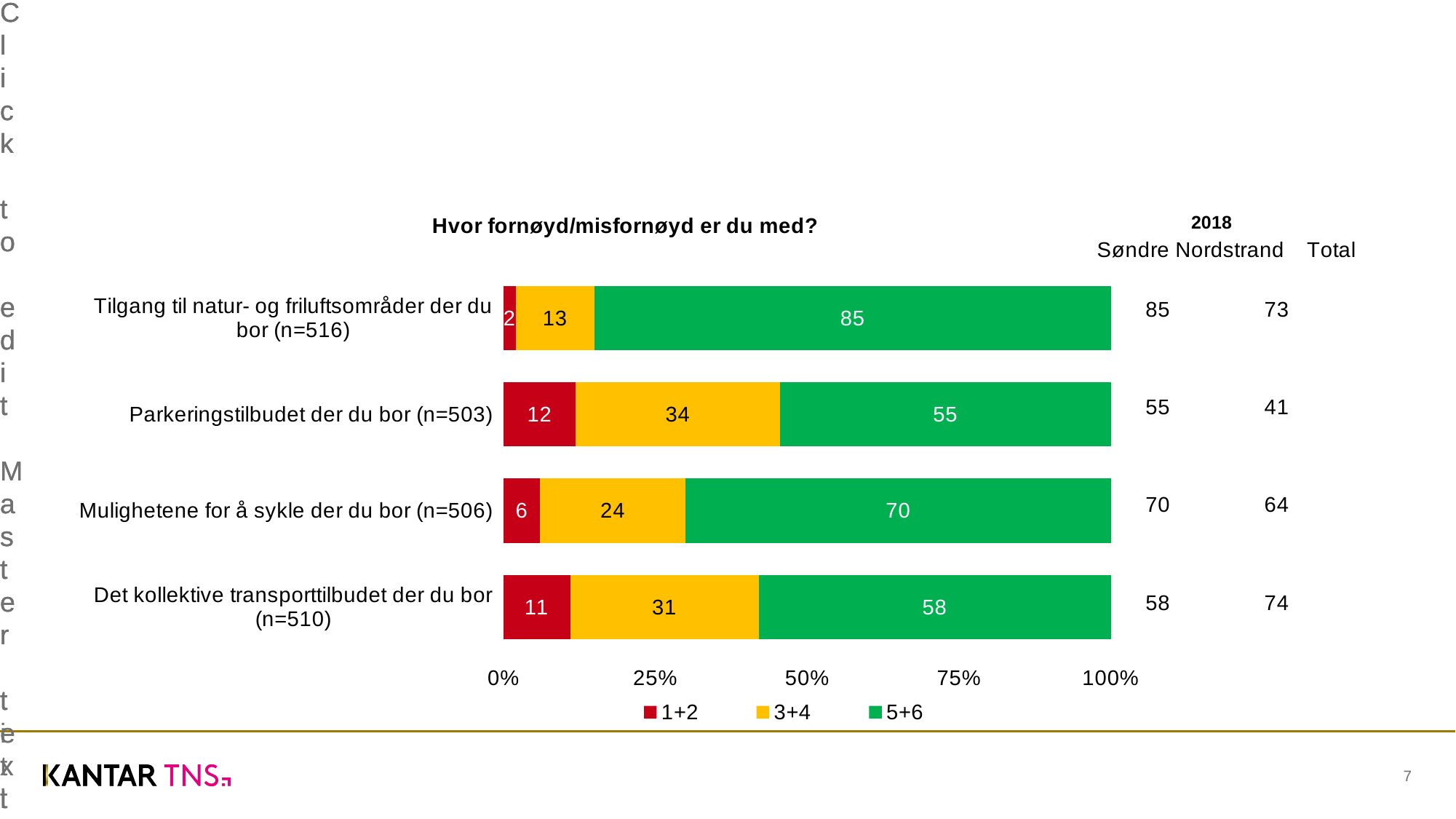
What is the total of the stacked bar for "Parkeringstilbudet der du bor (n=503)"? 101 What is the difference between the 5+6 values for "Mulighetene for å sykle der du bor (n=506)" and "Det kollektive transporttilbudet der du bor (n=510)"? 12 Which category has the lowest value for the 1+2 series? Tilgang til natur- og friluftsområder der du bor (n=516) What is the title of the chart? Hvor fornøyd/misfornøyd er du med? What is the value of the 5+6 series for "Parkeringstilbudet der du bor (n=503)"? 55 Which category has the highest value for the 5+6 series? Tilgang til natur- og friluftsområder der du bor (n=516) Which is larger: the 3+4 value for "Parkeringstilbudet der du bor (n=503)" or the 3+4 value for "Det kollektive transporttilbudet der du bor (n=510)"? Parkeringstilbudet der du bor (n=503) What kind of chart is shown on the slide? Stacked bar chart What is the value of the 1+2 series for "Det kollektive transporttilbudet der du bor (n=510)"? 11 How many categories are shown in the chart? 4 How many series does the legend list? 3 What is the value of the 3+4 series for "Mulighetene for å sykle der du bor (n=506)"? 24